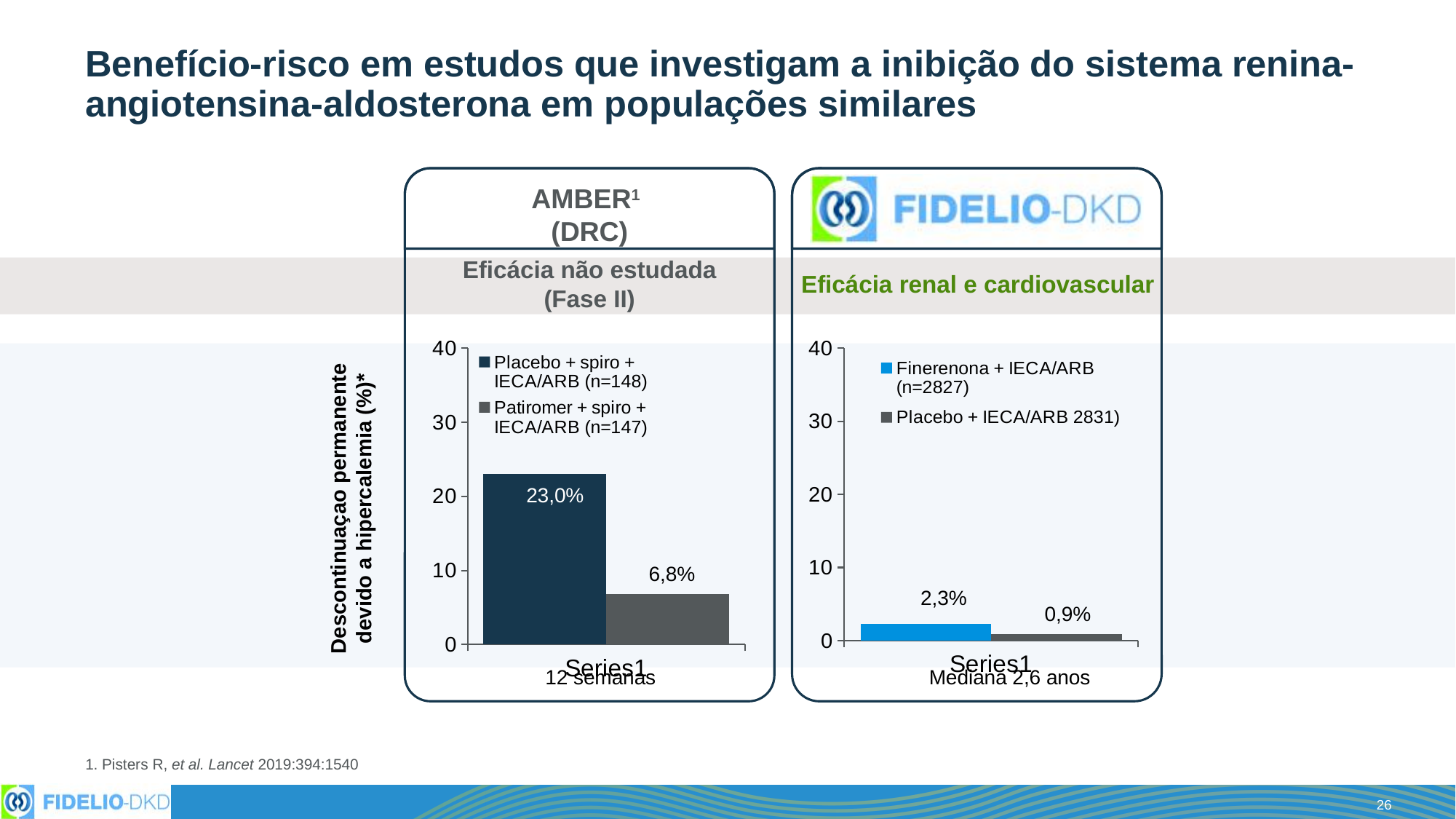
How many series does the legend of the FIDELIO-DKD chart on the right list? 2 In the AMBER (DRC) chart on the left, which series has the highest value? Placebo + spiro + IECA/ARB (n=148) In the AMBER (DRC) chart on the left, is the value for Placebo + spiro + IECA/ARB greater or less than 20? greater What is the y-axis label shared by the two charts? Descontinuação permanente devido a hipercalemia (%)* In the AMBER (DRC) chart on the left, what is the difference between the Placebo + spiro + IECA/ARB value and the Patiromer + spiro + IECA/ARB value? 16,2% In the AMBER (DRC) chart on the left, what is the value for Patiromer + spiro + IECA/ARB (n=147)? 6,8% In the FIDELIO-DKD chart on the right, which series has the lowest value? Placebo + IECA/ARB What kind of chart is the AMBER (DRC) chart on the left? Bar chart In the AMBER (DRC) chart on the left, what is the value for Placebo + spiro + IECA/ARB (n=148)? 23,0% In the FIDELIO-DKD chart on the right, what is the difference between the Finerenona + IECA/ARB value and the Placebo + IECA/ARB value? 1,4% In the FIDELIO-DKD chart on the right, what is the value for Placebo + IECA/ARB? 0,9% In the FIDELIO-DKD chart on the right, what is the value for Finerenona + IECA/ARB (n=2827)? 2,3%